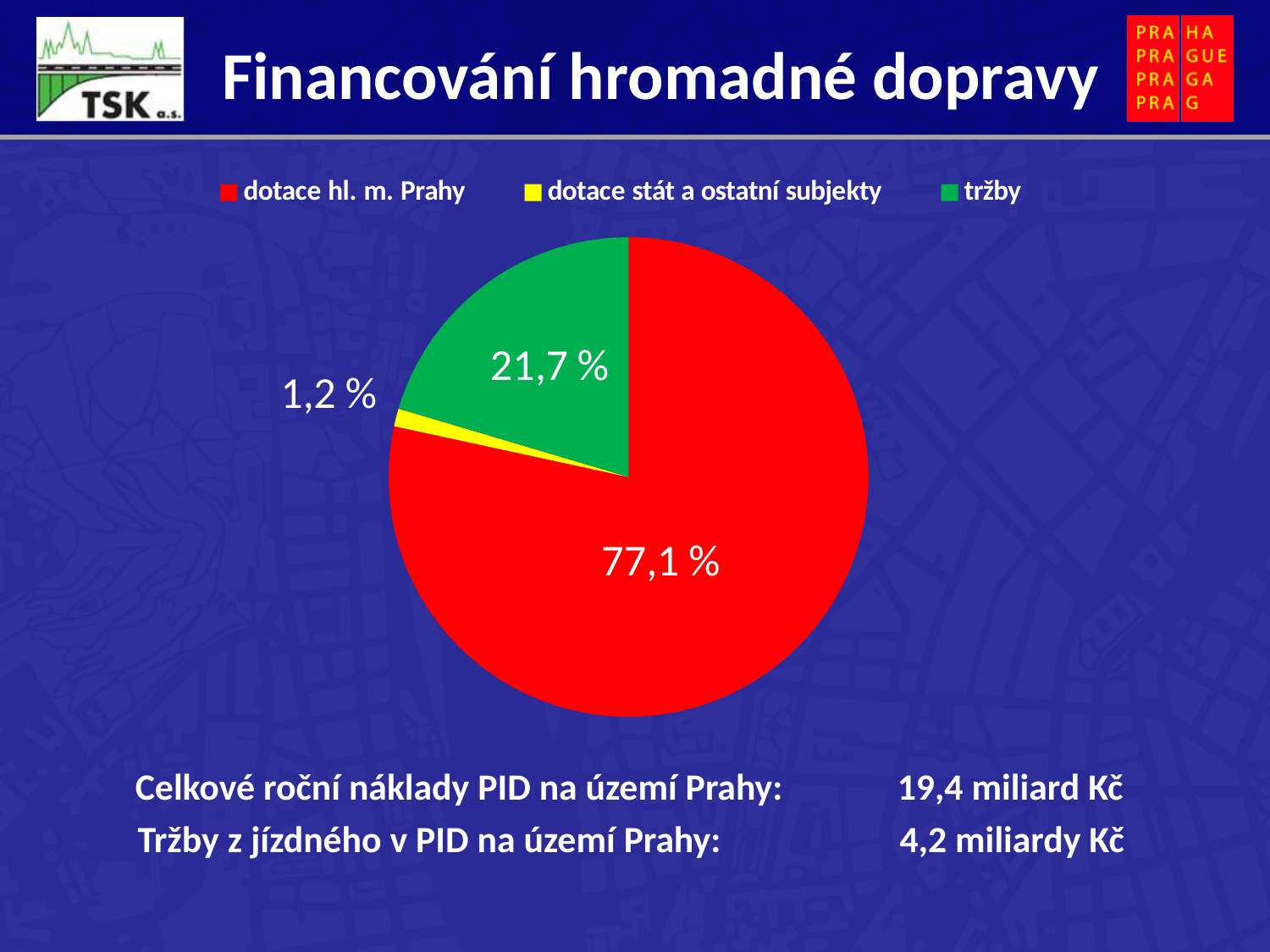
What kind of chart is shown on the slide? pie chart What is the difference in percentage points between 'dotace hl. m. Prahy' and 'tržby'? 55,4 What colour is the slice for 'tržby'? green What share of the pie does 'tržby' represent? 21,7 % What colour is the slice for 'dotace stát a ostatní subjekty'? yellow Which category has the smallest slice of the pie? dotace stát a ostatní subjekty How many categories does the pie chart show? 3 What share of the pie does 'dotace stát a ostatní subjekty' represent? 1,2 % What is the difference in percentage points between 'tržby' and 'dotace stát a ostatní subjekty'? 20,5 Which is larger, the share for 'tržby' or the share for 'dotace stát a ostatní subjekty'? tržby What share of the pie does 'dotace hl. m. Prahy' represent? 77,1 % Which category has the largest slice of the pie? dotace hl. m. Prahy